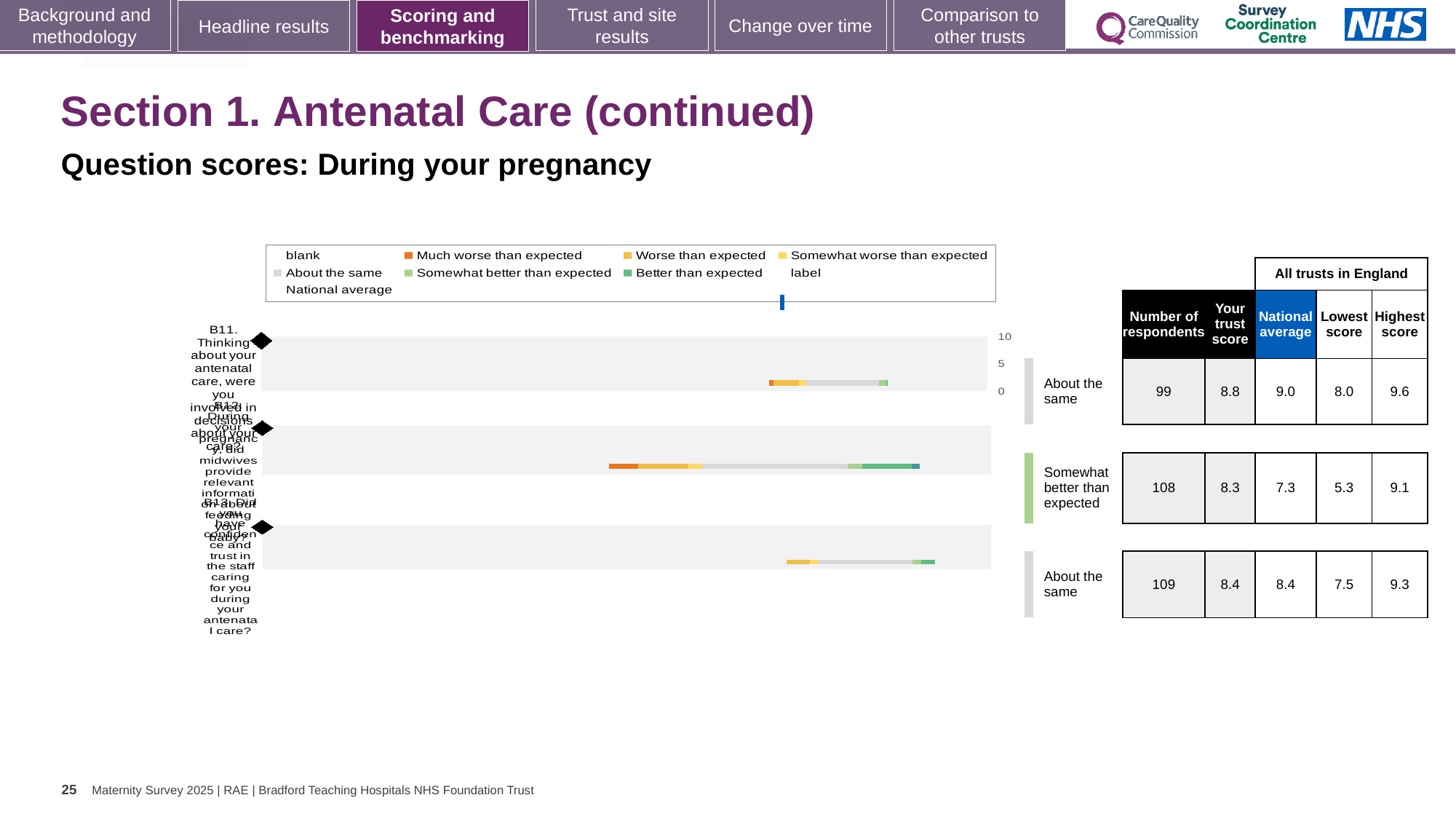
What benchmark category is shown for question B12? Somewhat better than expected What is the national average for question B13? 8.4 For question B11, which is larger: the trust score or the national average? National average What is the trust score for question B12? 8.3 What is the number of respondents for question B11? 99 Which question has the lowest trust score? B12 Which question has the highest number of respondents? B13 What is the difference between the trust score and the national average for question B12? 1.0 What is the lowest score across all trusts in England for question B12? 5.3 What is the highest score across all trusts in England for question B11? 9.6 How many questions (bars) are plotted in the chart? 3 What kind of chart is shown on the slide? bar chart